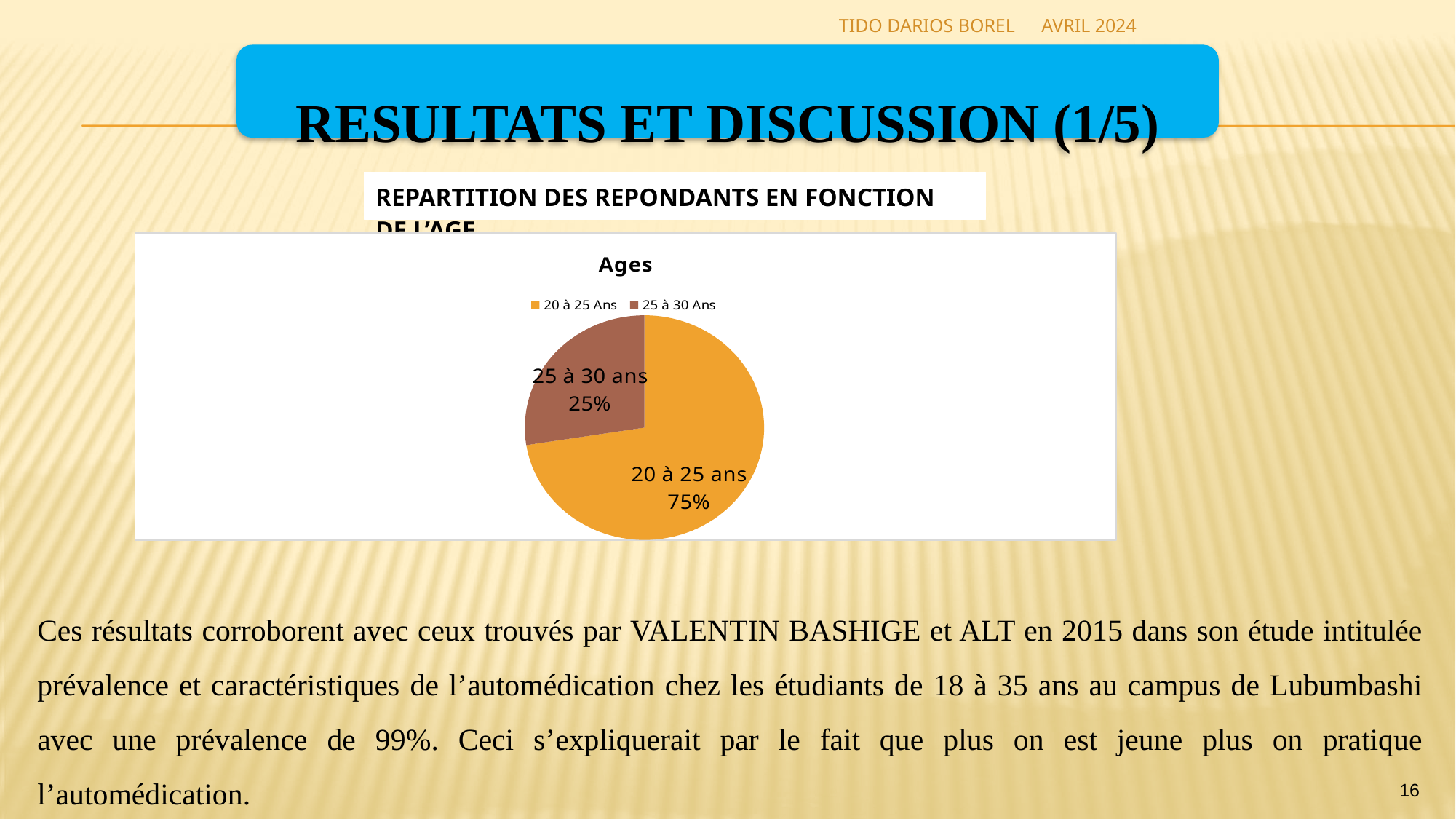
What kind of chart is shown on the slide? pie chart What is the title of the chart? Ages What is the difference in percentage points between the 20 à 25 ans and 25 à 30 ans slices? 50 Which age group has the largest share of the pie? 20 à 25 ans What share of respondents are in the 25 à 30 ans group? 25% How many slices does the pie chart have? 2 How many entries does the legend list? 2 Which slice is larger, 20 à 25 ans or 25 à 30 ans? 20 à 25 ans What colour is the 25 à 30 Ans slice? brown What share of respondents are in the 20 à 25 ans group? 75% Which age group has the smallest share of the pie? 25 à 30 ans